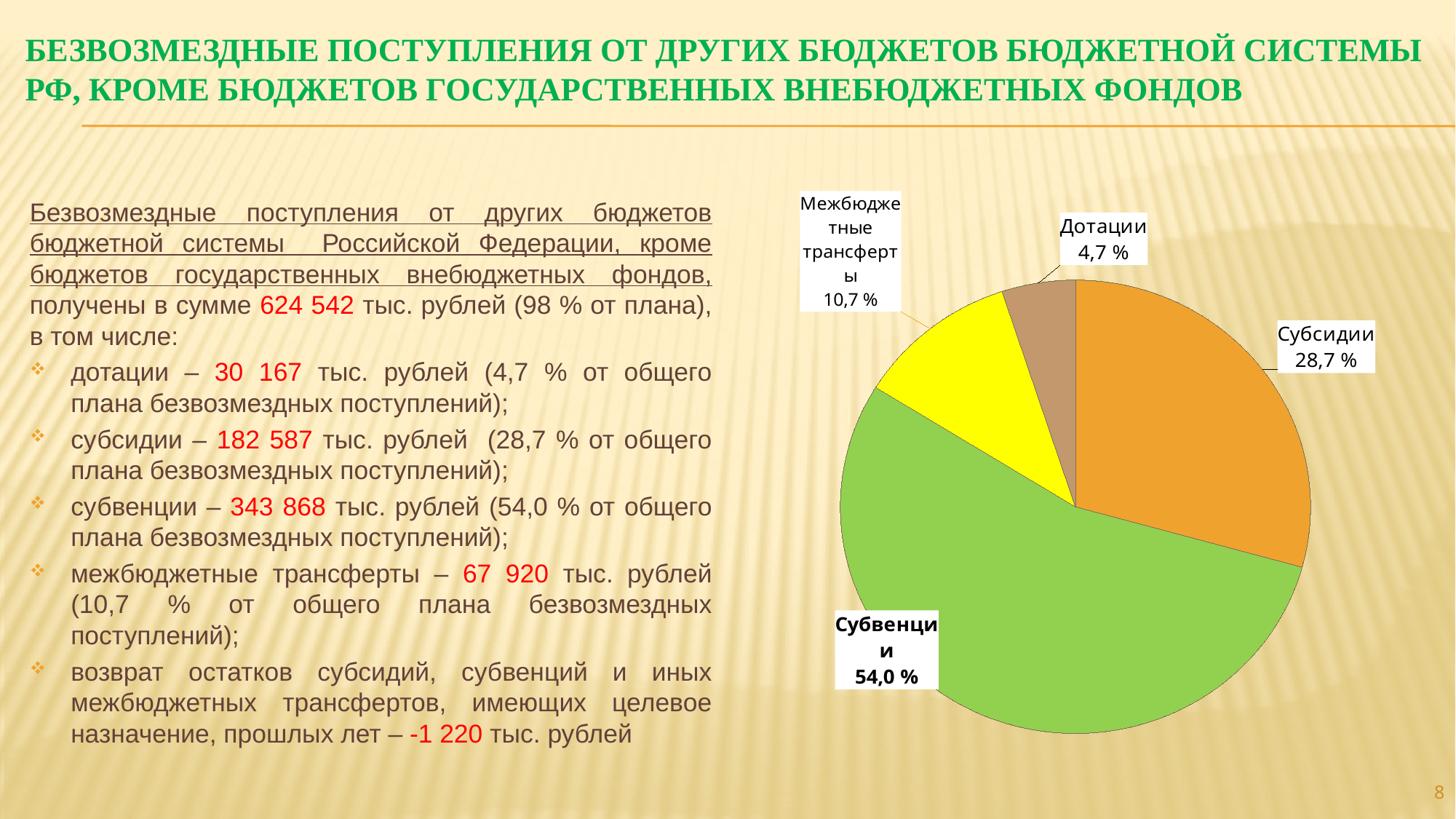
What is the difference between the shares of Межбюджетные трансферты and Дотации in the pie chart? 6,0 % How many slices does the pie chart have? 4 What colour is the Субвенции slice in the pie chart? Green Which is larger in the pie chart, Субсидии or Межбюджетные трансферты? Субсидии Which slice of the pie chart is the largest? Субвенции What is the value shown for Межбюджетные трансферты in the pie chart? 10,7 % What is the difference between the shares of Субвенции and Субсидии in the pie chart? 25,3 % What is the value shown for Субсидии in the pie chart? 28,7 % What share of the pie does Субвенции account for? 54,0 % What is the value shown for Дотации in the pie chart? 4,7 % What kind of chart is shown on the slide? Pie chart Which slice of the pie chart is the smallest? Дотации